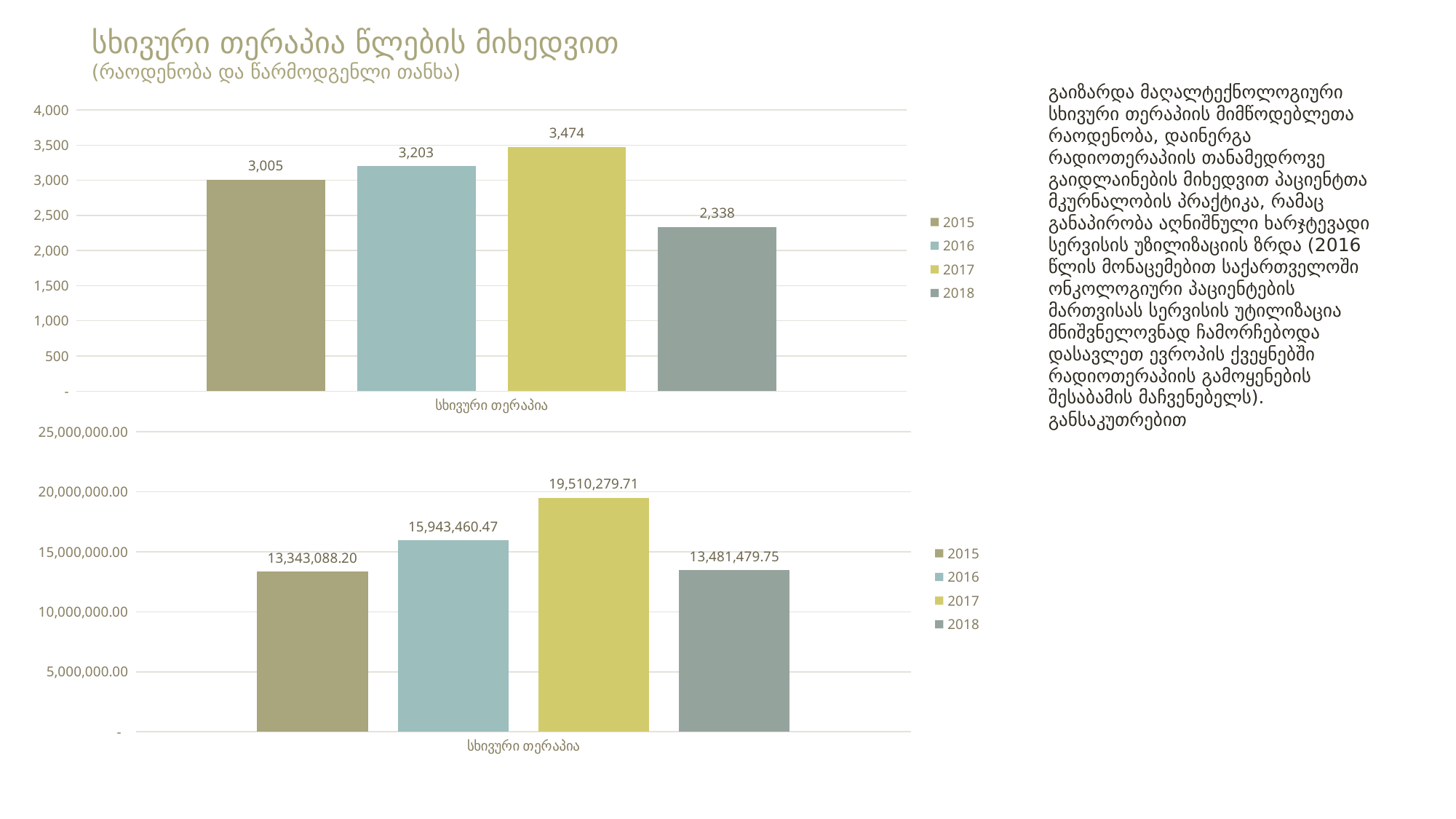
How many series does the legend of the bottom chart list? 4 In the top chart, which year has the highest value? 2017 In the bottom chart, what is the value for 2016? 15,943,460.47 In the top chart, what is the difference between the values for 2017 and 2018? 1,136 What kind of chart is the top chart? bar chart In the bottom chart, which year has the lowest value? 2015 In the bottom chart, is the value for 2017 greater or less than 15,000,000.00? greater In the top chart, what is the value for 2018? 2,338 In the top chart, which is larger, the value for 2015 or the value for 2016? 2016 In the bottom chart, what is the value for 2015? 13,343,088.20 In the top chart, which colour represents 2017? yellow In the top chart, what is the value for 2017? 3,474